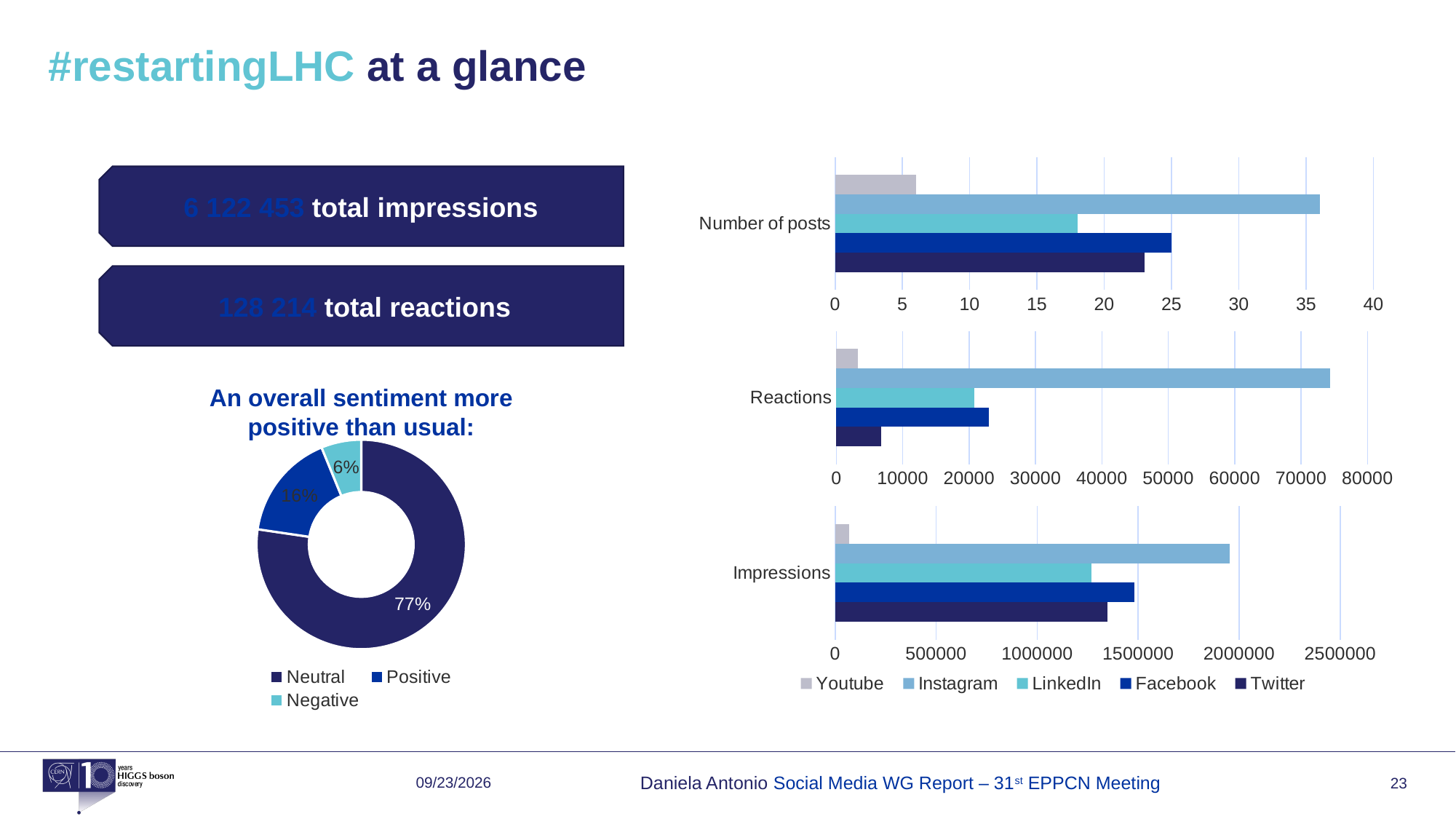
In the donut chart on the left, which sentiment category has the largest share? Neutral How many series does the legend of the charts on the right list? 5 In the Reactions chart on the right, is the value for Instagram greater or less than 70000? greater In the donut chart on the left, what share of sentiment is Neutral? 77% In the Impressions chart on the right, is the value for Youtube greater or less than 500000? less In the Number of posts chart on the right, is the value for LinkedIn greater or less than 20? less In the Impressions chart on the right, which has more impressions, Facebook or Twitter? Facebook In the donut chart on the left, what share of sentiment is Positive? 16% In the donut chart on the left, how many categories does the legend list? 3 In the Number of posts chart on the right, which platform has the highest number of posts? Instagram In the Reactions chart on the right, which platform has the lowest number of reactions? Youtube In the donut chart on the left, what share of sentiment is Negative? 6%